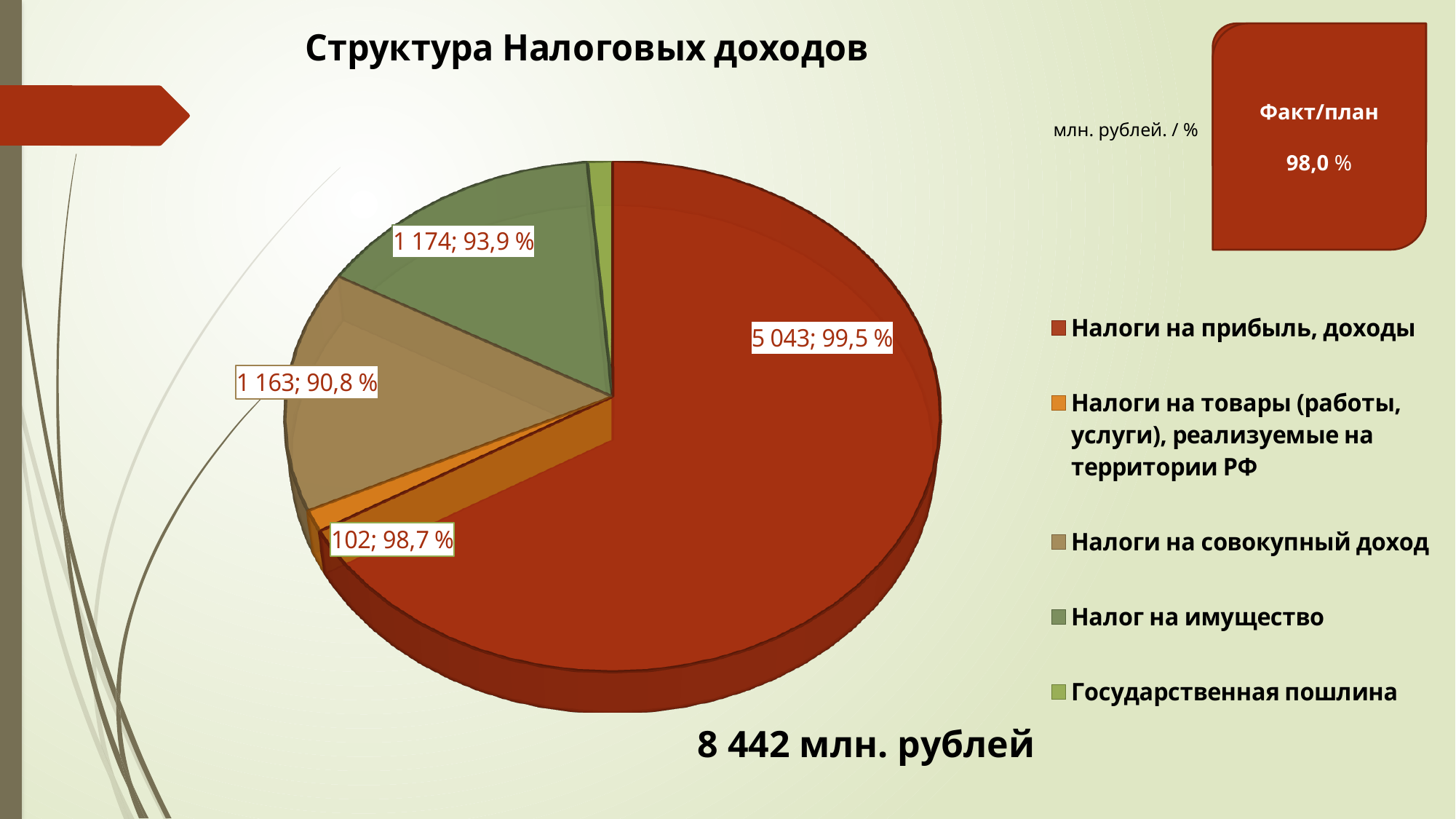
Which category has the largest slice of the pie? Налоги на прибыль, доходы What is the difference in млн. рублей between Налог на имущество and Налоги на совокупный доход? 11 What value in млн. рублей is shown for Налоги на прибыль, доходы? 5 043 Which category has the smallest slice of the pie? Государственная пошлина What type of chart is shown on the slide? pie chart What fact/plan percentage is shown for Налоги на прибыль, доходы? 99,5 % What value in млн. рублей is shown for Налоги на совокупный доход? 1 163 What is the title of the chart? Структура Налоговых доходов How many categories does the legend list? 5 What value in млн. рублей is shown for Налоги на товары (работы, услуги), реализуемые на территории РФ? 102 What fact/plan percentage is shown for Налоги на совокупный доход? 90,8 % What value in млн. рублей is shown for Налог на имущество? 1 174